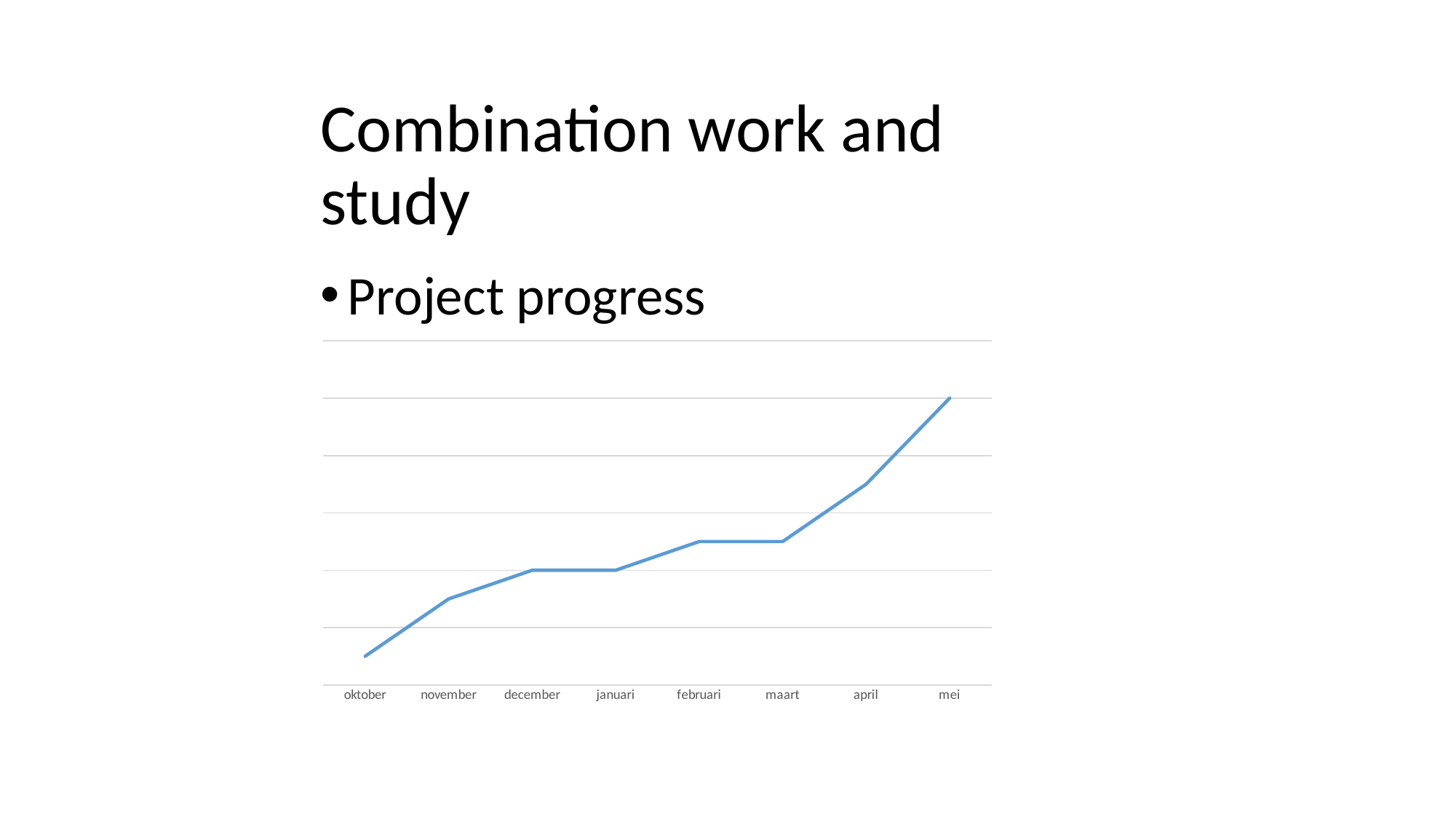
Which is larger, the value for april or the value for november? april Which month has the highest value in the chart? mei What is the last month label on the x axis of the chart? mei Which is larger, the value for mei or the value for maart? mei Which month has the lowest value in the chart? oktober What is the first month label on the x axis of the chart? oktober Do the values in the chart generally rise or fall from oktober to mei? rise How many months are plotted along the x axis of the chart? 8 What kind of chart is shown on the slide? line chart Which is larger, the value for oktober or the value for februari? februari